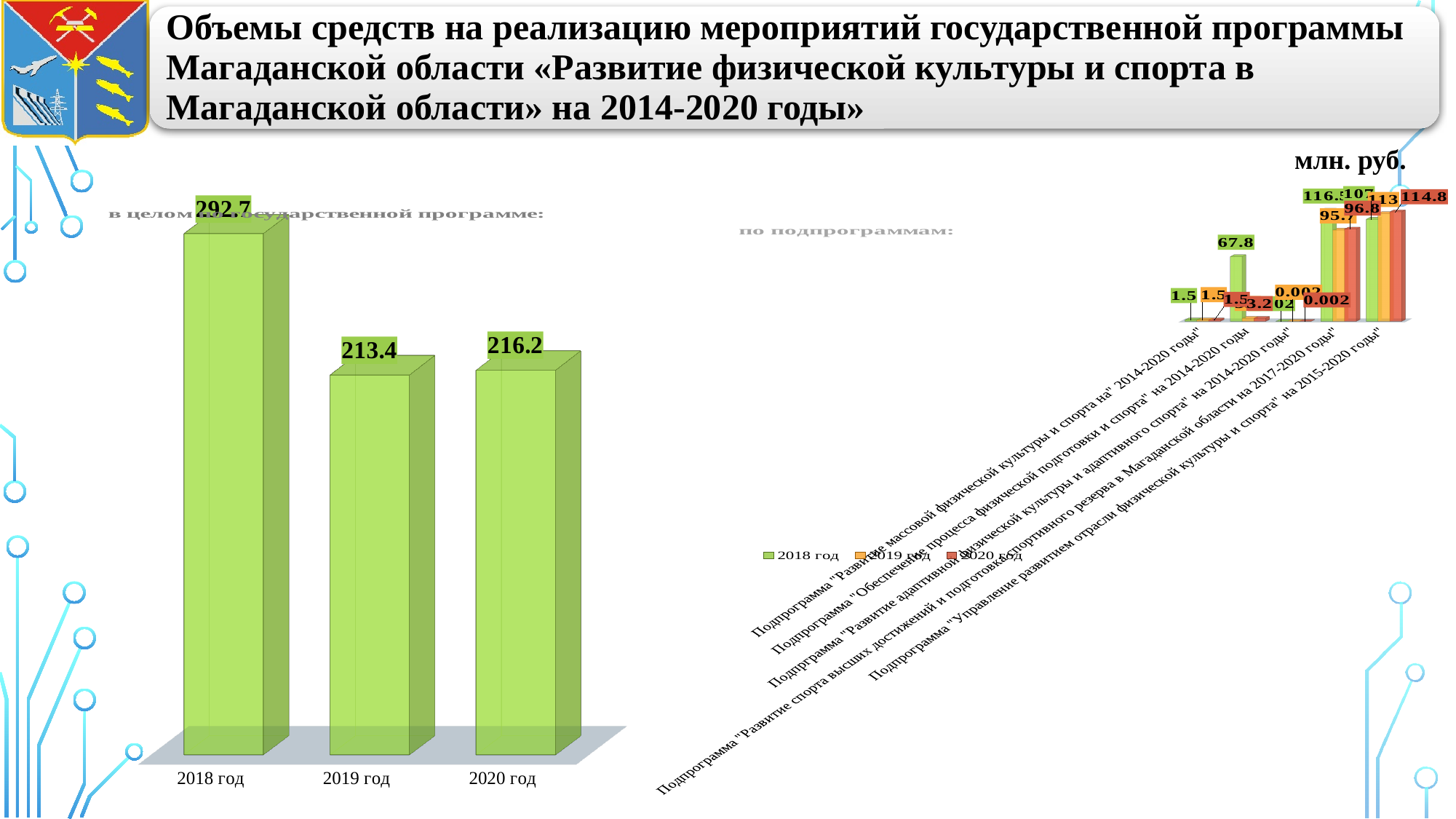
What type of chart is the left chart (в целом по государственной программе)? bar chart On the left chart (в целом по государственной программе), what is the difference between the values for 2020 год and 2019 год? 2.8 On the left chart (в целом по государственной программе), what is the value for 2018 год? 292.7 On the right chart (по подпрограммам), how many series does the legend list? 3 On the left chart (в целом по государственной программе), what is the difference between the values for 2018 год and 2019 год? 79.3 What unit of measurement is indicated on the slide for the chart values? млн. руб. On the left chart (в целом по государственной программе), which is larger: the value for 2018 год or 2020 год? 2018 год On the left chart (в целом по государственной программе), how many bars are shown? 3 On the left chart (в целом по государственной программе), which year has the lowest value? 2019 год On the left chart (в целом по государственной программе), what is the value for 2019 год? 213.4 On the left chart (в целом по государственной программе), which year has the highest value? 2018 год On the left chart (в целом по государственной программе), what is the value for 2020 год? 216.2